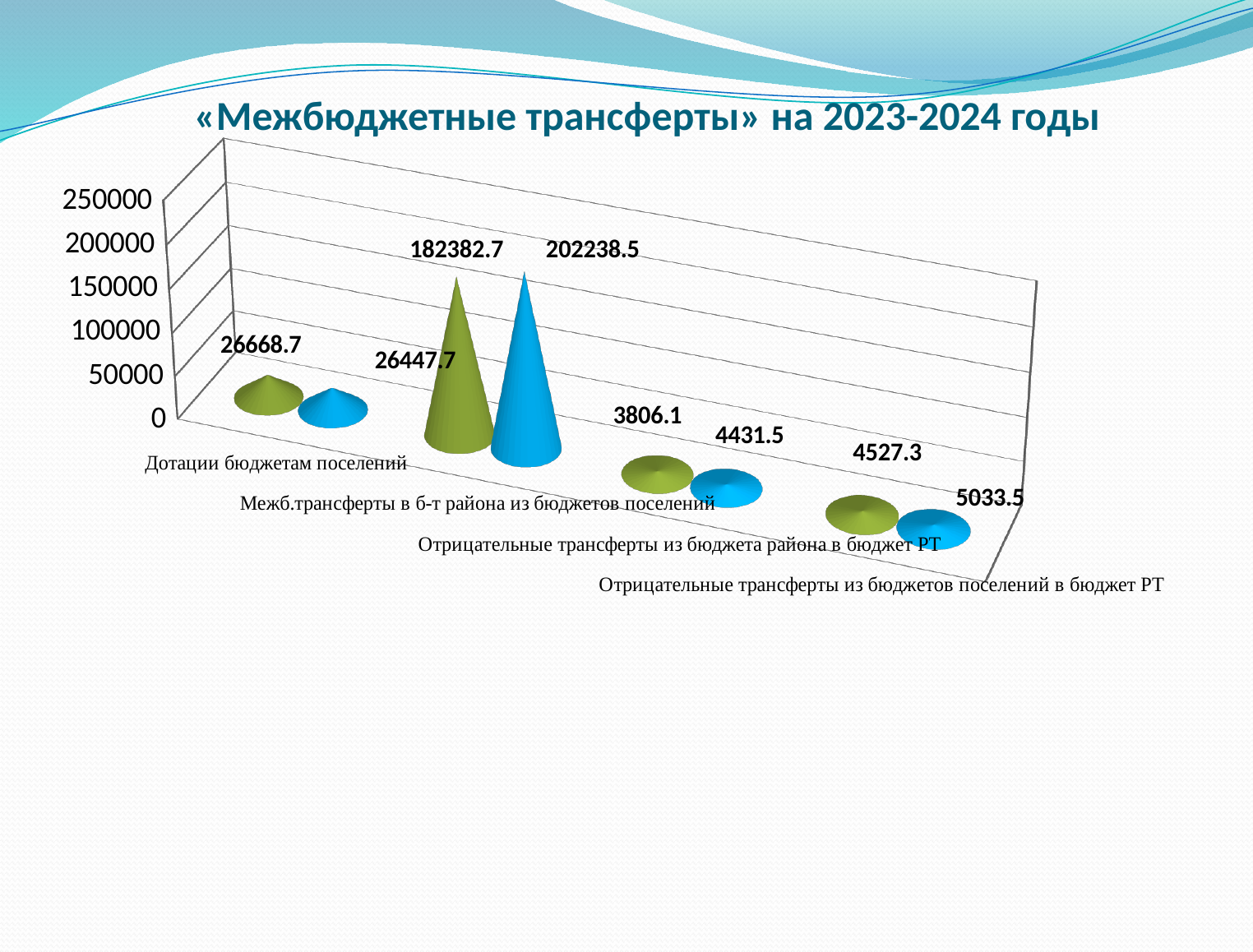
What is the title of the chart? «Межбюджетные трансферты» на 2023-2024 годы What is the difference between the blue and green values for «Межб.трансферты в б-т района из бюджетов поселений»? 19855.8 Which category has the highest value in the green series? Межб.трансферты в б-т района из бюджетов поселений Is the blue value for «Межб.трансферты в б-т района из бюджетов поселений» greater or less than 200000? greater What is the value of the blue series for «Межб.трансферты в б-т района из бюджетов поселений»? 202238.5 What is the difference between the blue and green values for «Отрицательные трансферты из бюджетов поселений в бюджет РТ»? 506.2 For «Дотации бюджетам поселений», which is larger: the green value or the blue value? green Which category has the lowest value in the blue series? Отрицательные трансферты из бюджета района в бюджет РТ How many categories are shown on the x axis? 4 What is the value of the green series for «Отрицательные трансферты из бюджета района в бюджет РТ»? 3806.1 What kind of chart is shown on the slide? bar chart What is the value of the green series for «Дотации бюджетам поселений»? 26668.7